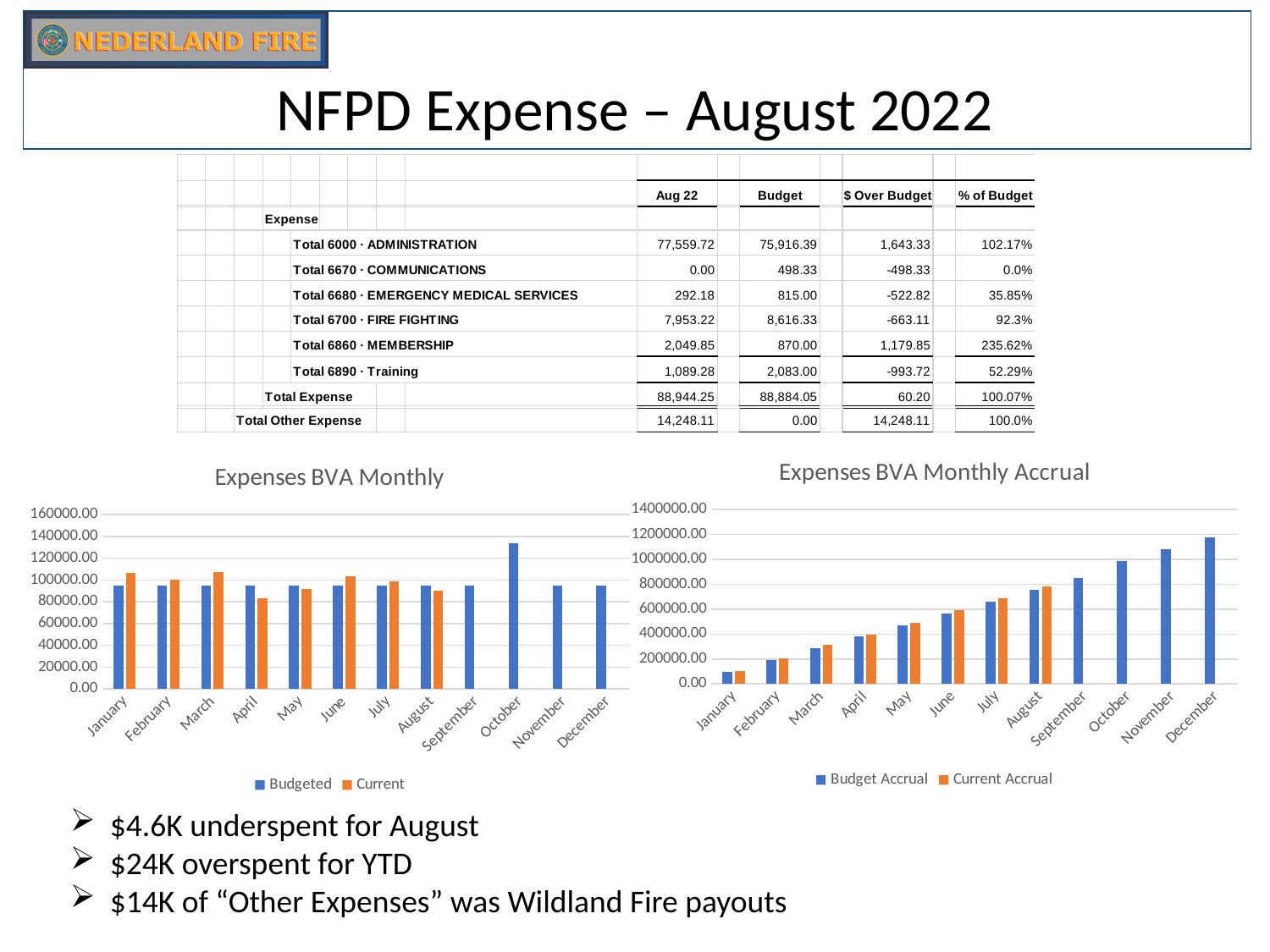
In the Expenses BVA Monthly chart, which is larger for March, the Budgeted value or the Current value? Current In the Expenses BVA Monthly Accrual chart, which month has the highest Budget Accrual value? December In the Expenses BVA Monthly Accrual chart, do the Budget Accrual values rise or fall from January to December? rise In the Expenses BVA Monthly chart, is the Budgeted value for October greater or less than 120000.00? greater In the Expenses BVA Monthly Accrual chart, is the Budget Accrual value for December greater or less than 1000000.00? greater In the Expenses BVA Monthly Accrual chart, what colour are the Current Accrual bars? orange In the Expenses BVA Monthly chart, how many series does the legend list? 2 In the Expenses BVA Monthly chart, is the Current value for April greater or less than 100000.00? less In the Expenses BVA Monthly chart, how many months are shown on the x axis? 12 In the Expenses BVA Monthly Accrual chart, how many series does the legend list? 2 In the Expenses BVA Monthly chart, what kind of chart is shown? bar chart In the Expenses BVA Monthly chart, which month has the highest Budgeted value? October